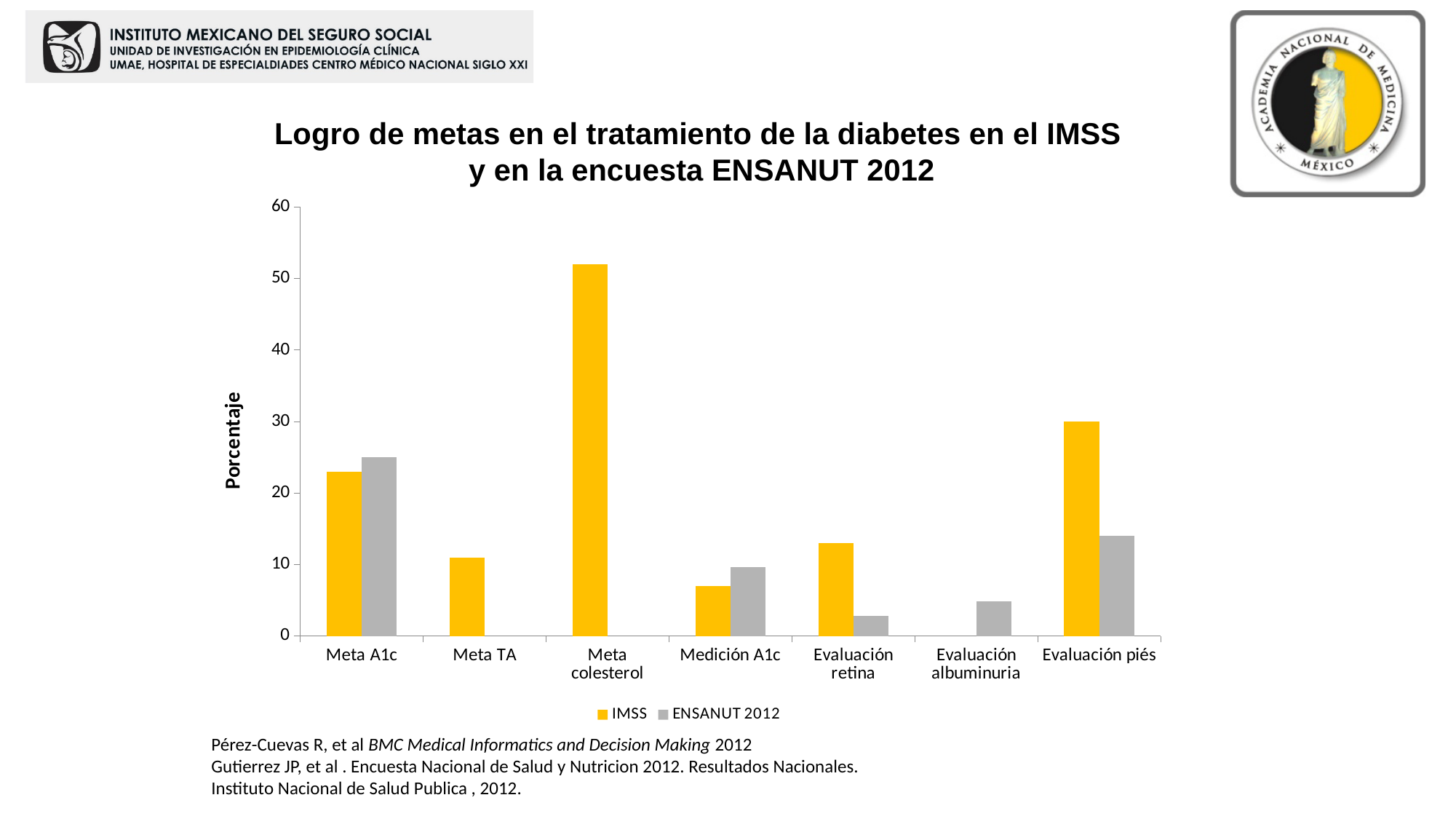
What is the label of the y axis? Porcentaje Is the IMSS value for Meta colesterol greater or less than 50? greater Which category has the lowest ENSANUT 2012 value among those with a visible ENSANUT 2012 bar? Evaluación retina Is the IMSS value for Meta TA greater or less than 20? less For Evaluación retina, which series has the larger value, IMSS or ENSANUT 2012? IMSS Which category has the highest ENSANUT 2012 value? Meta A1c What kind of chart is shown on the slide? bar chart Which category has the highest IMSS value? Meta colesterol For Medición A1c, which series has the larger value, IMSS or ENSANUT 2012? ENSANUT 2012 Is the ENSANUT 2012 value for Evaluación piés greater or less than 20? less How many series does the legend list? 2 How many categories are shown on the x axis? 7